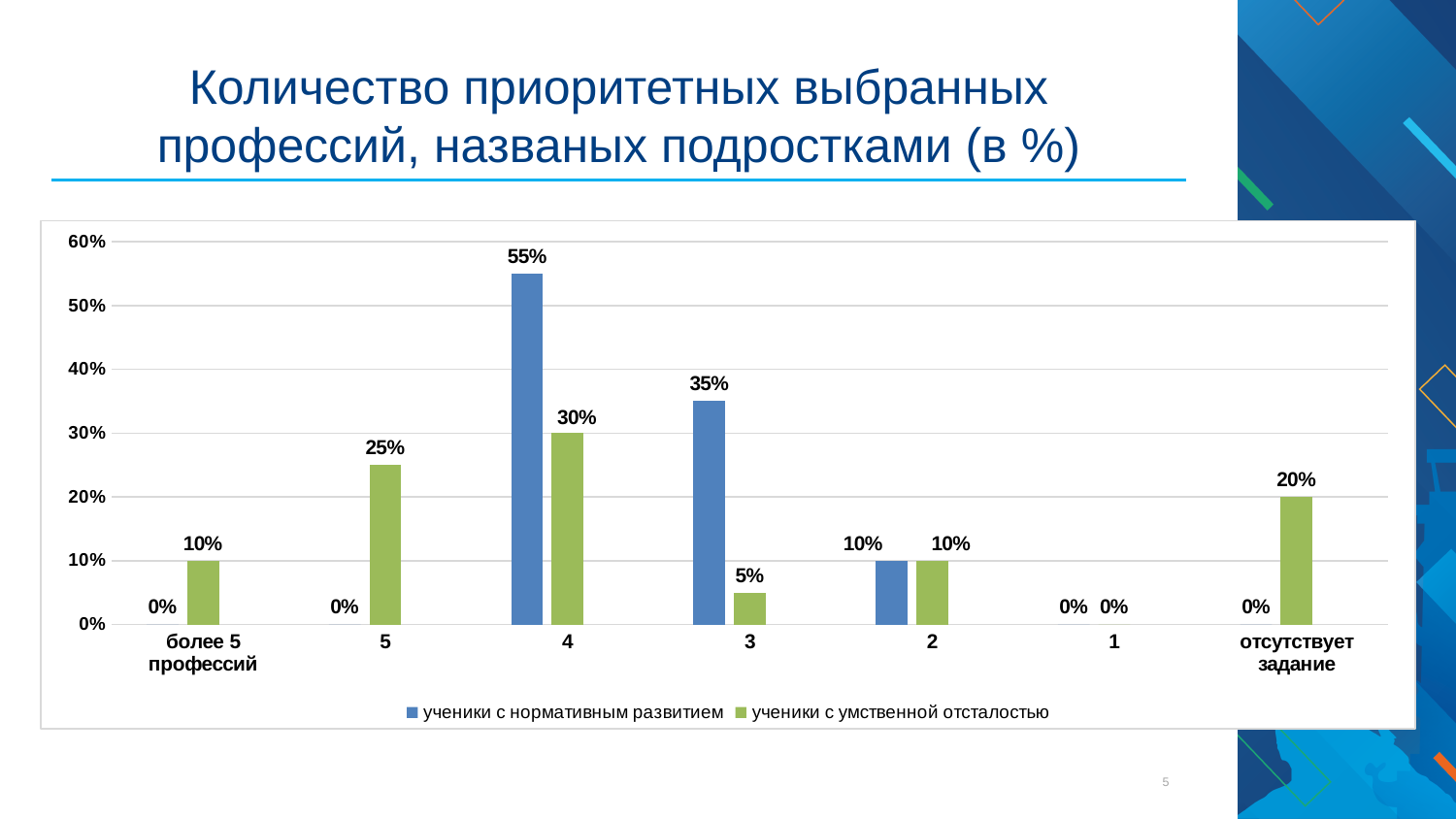
What colour represents "ученики с умственной отсталостью" in the chart? green How many series does the legend list? 2 Which series has the larger value in category "5"? ученики с умственной отсталостью In which category does "ученики с умственной отсталостью" have its highest value? 4 What is the value for "ученики с умственной отсталостью" in category "отсутствует задание"? 20% What is the value for "ученики с нормативным развитием" in category "более 5 профессий"? 0% How many categories are shown on the x axis? 7 What is the difference between "ученики с нормативным развитием" and "ученики с умственной отсталостью" in category "3"? 30% What type of chart is shown on the slide? bar chart What is the value for "ученики с нормативным развитием" in category "4"? 55% In which category does "ученики с нормативным развитием" have its highest value? 4 What is the value for "ученики с умственной отсталостью" in category "5"? 25%